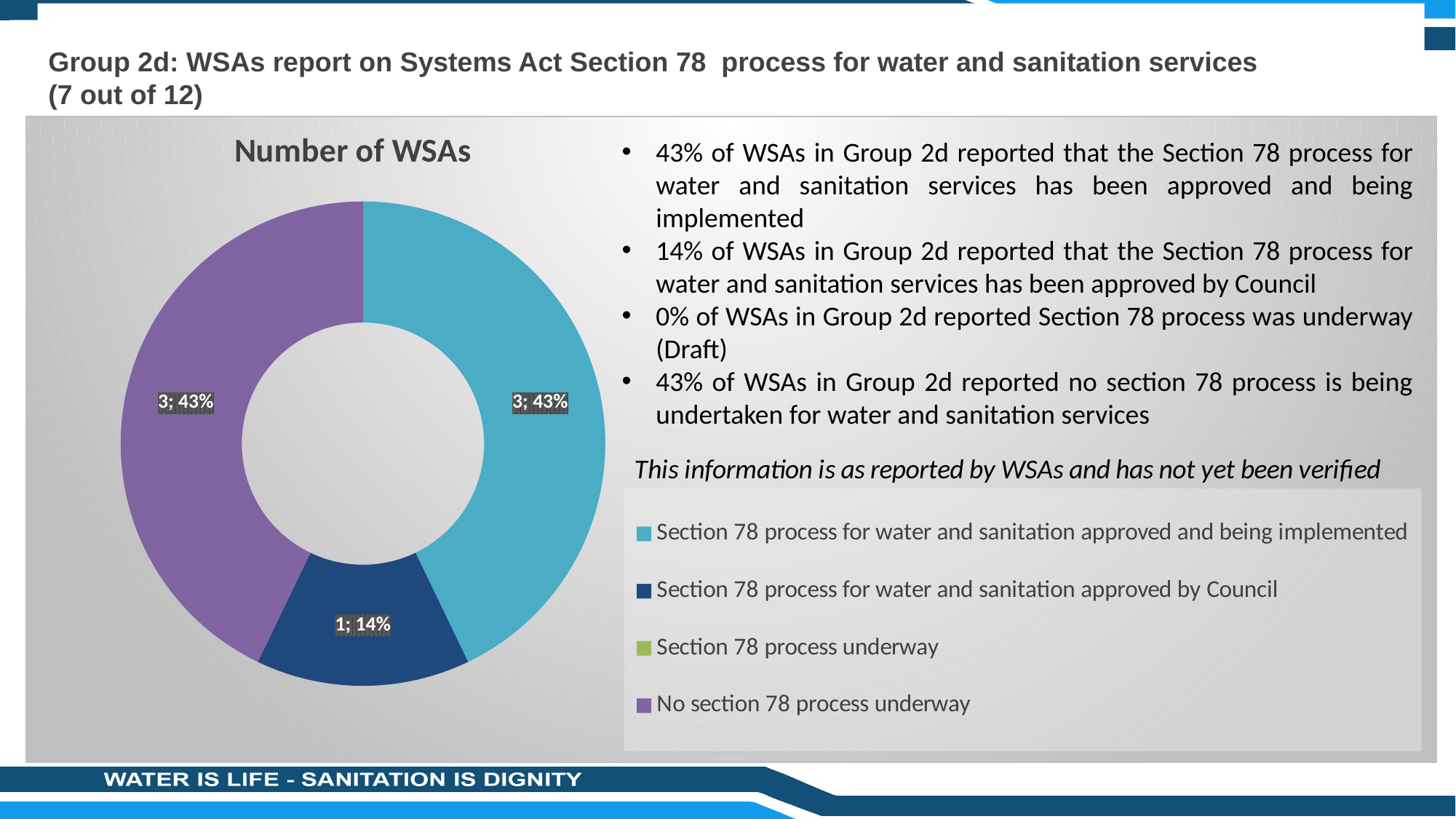
How many WSAs reported no section 78 process underway? 3 How many categories does the legend list? 4 What kind of chart is shown on the slide? Pie chart (doughnut) What share of the pie is 'No section 78 process underway'? 43% What share of the pie is 'Section 78 process for water and sanitation approved by Council'? 14% How many WSAs reported that the Section 78 process for water and sanitation was approved and being implemented? 3 What is the difference in the number of WSAs between 'No section 78 process underway' and 'Section 78 process for water and sanitation approved by Council'? 2 What is the title of the chart? Number of WSAs How many WSAs reported that the Section 78 process for water and sanitation was approved by Council? 1 Which category has the smallest non-zero slice in the chart? Section 78 process for water and sanitation approved by Council Which is larger: the slice for 'Section 78 process for water and sanitation approved and being implemented' or the slice for 'Section 78 process for water and sanitation approved by Council'? Section 78 process for water and sanitation approved and being implemented What colour represents 'No section 78 process underway' in the chart? Purple